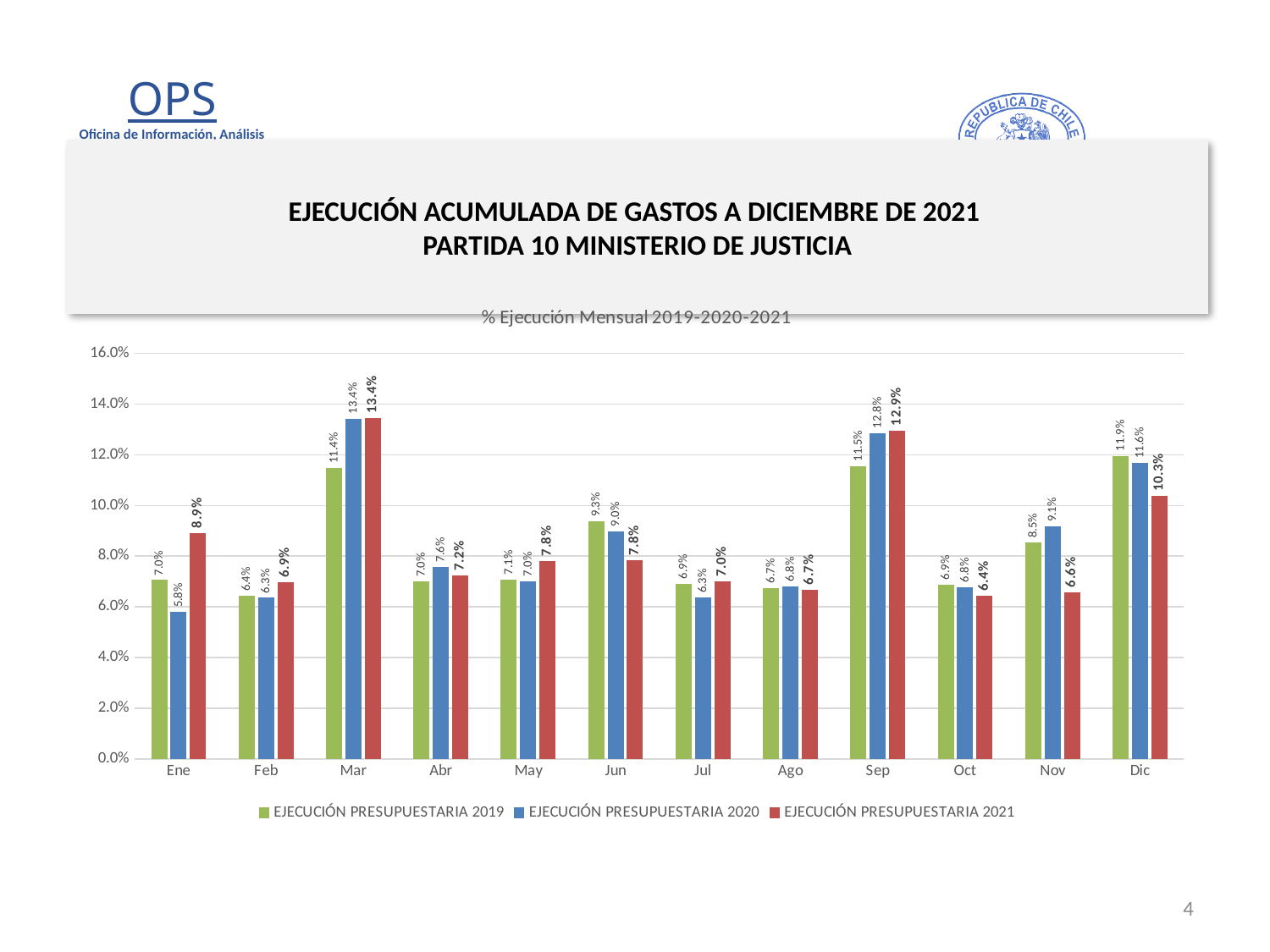
What is the title of the chart? % Ejecución Mensual 2019-2020-2021 What is the difference between the EJECUCIÓN PRESUPUESTARIA 2021 and EJECUCIÓN PRESUPUESTARIA 2019 values in Ene? 1.9% What is the value for EJECUCIÓN PRESUPUESTARIA 2021 in Ene? 8.9% What is the value for EJECUCIÓN PRESUPUESTARIA 2019 in Dic? 11.9% How many series does the legend list? 3 Is the value for EJECUCIÓN PRESUPUESTARIA 2019 in Mar greater or less than 10.0%? greater What is the value for EJECUCIÓN PRESUPUESTARIA 2020 in Sep? 12.8% How many months are shown on the x axis? 12 Which is larger in Nov: the EJECUCIÓN PRESUPUESTARIA 2020 value or the EJECUCIÓN PRESUPUESTARIA 2021 value? EJECUCIÓN PRESUPUESTARIA 2020 In which month is the EJECUCIÓN PRESUPUESTARIA 2021 value highest? Mar In which month is the EJECUCIÓN PRESUPUESTARIA 2020 value lowest? Ene What kind of chart is shown on the slide? Bar chart